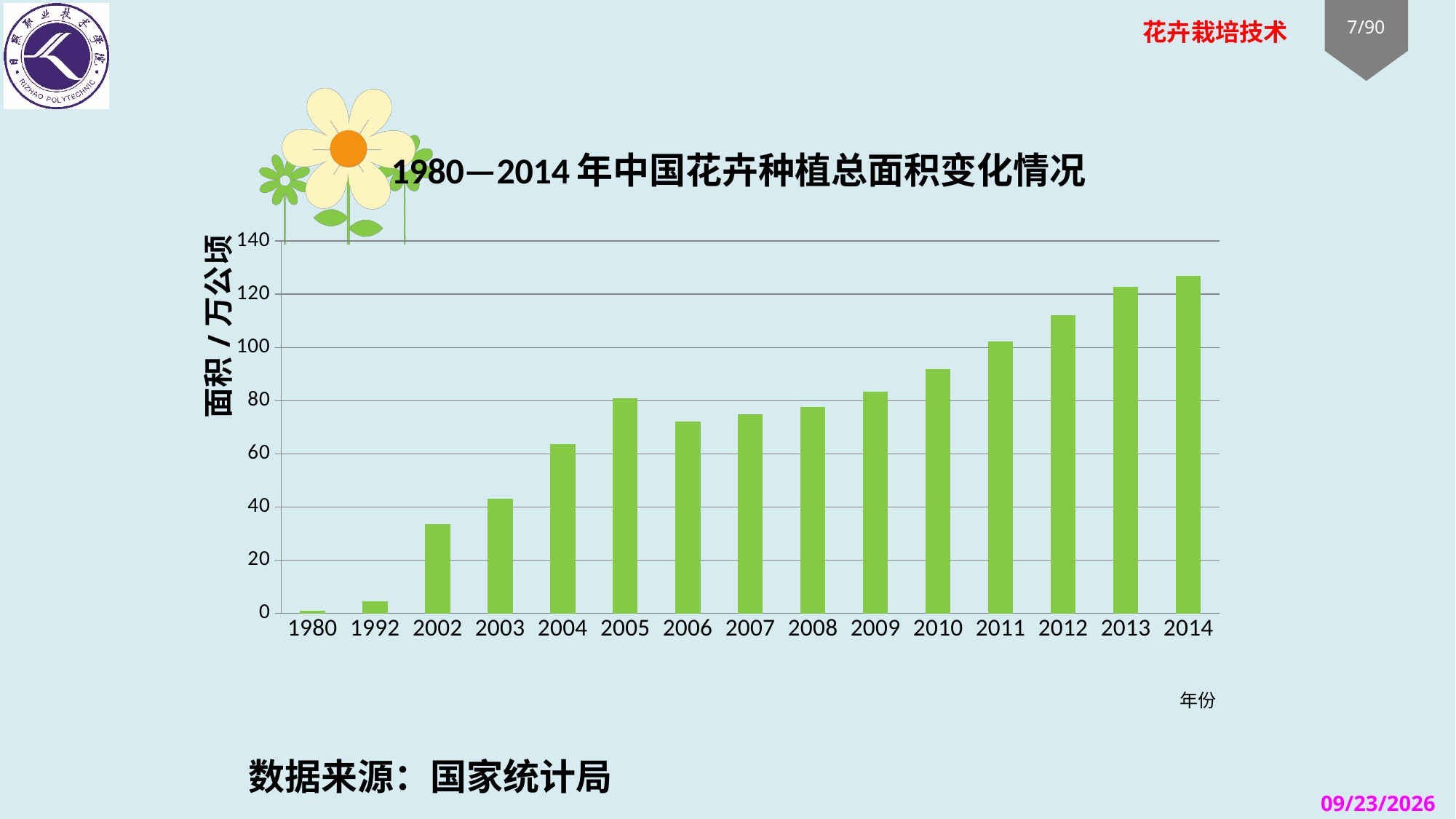
Which year has the lowest planting area? 1980 Is the value for 2012 greater or less than 100? greater What is the label of the vertical axis? 面积／万公顷 What kind of chart is shown on the slide? bar chart Which year has the highest planting area? 2014 Is the value for 2014 greater or less than 120? greater Overall, do the values rise or fall from 1980 to 2014? rise Which year has the larger value, 2003 or 2004? 2004 Which year has the larger value, 2005 or 2006? 2005 How many years (categories) are plotted on the x axis? 15 Is the value for 2002 greater or less than 40? less